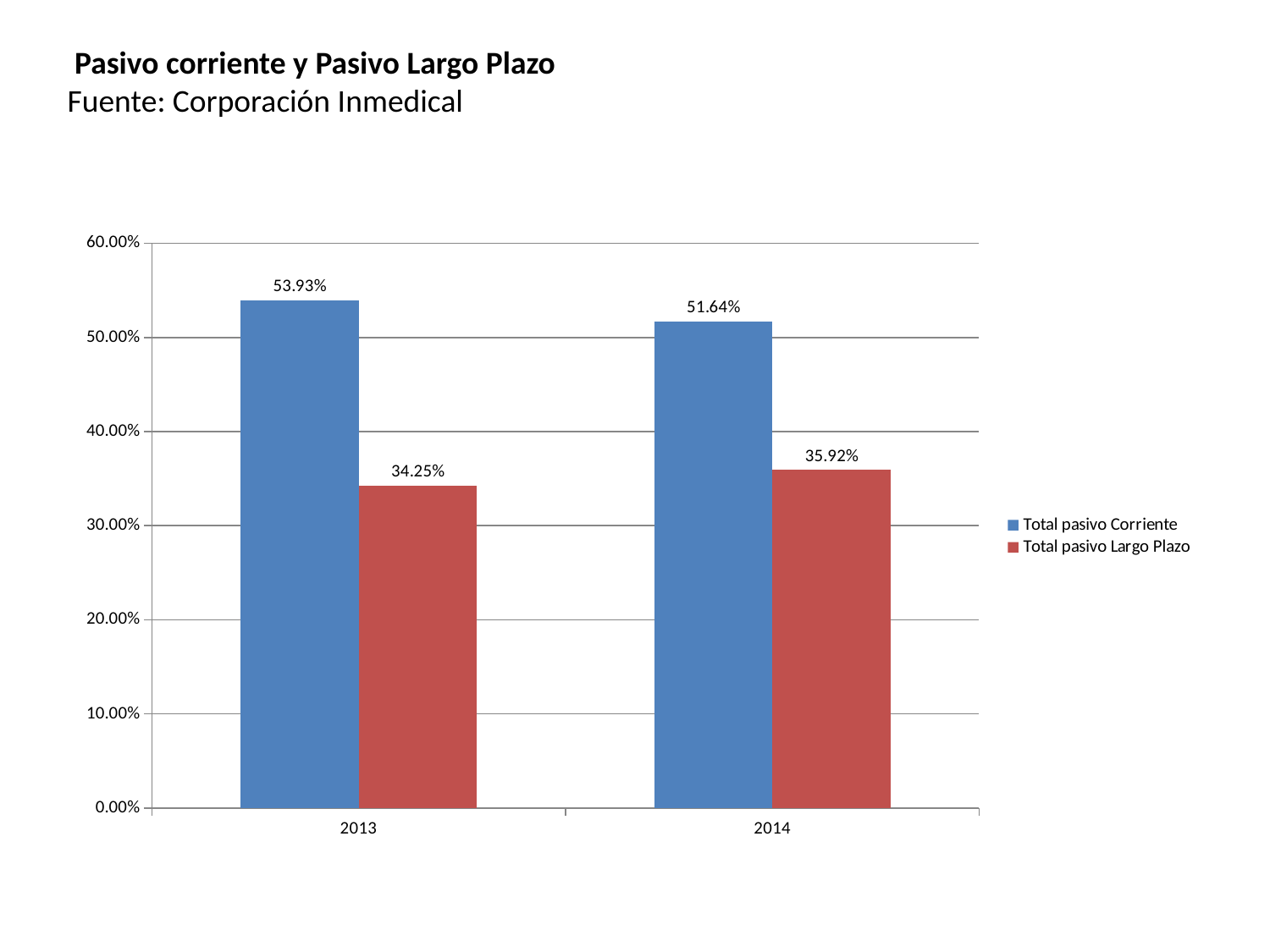
What is the value of Total pasivo Largo Plazo for 2014? 35.92% What is the value of Total pasivo Largo Plazo for 2013? 34.25% Which is larger in 2014, Total pasivo Corriente or Total pasivo Largo Plazo? Total pasivo Corriente What is the value of Total pasivo Corriente for 2013? 53.93% What kind of chart is shown on the slide? Bar chart How many years are shown on the x axis? 2 How many series does the legend list? 2 What is the difference between Total pasivo Corriente and Total pasivo Largo Plazo in 2013? 19.68% What is the value of Total pasivo Corriente for 2014? 51.64% In which year is Total pasivo Corriente highest? 2013 In which year is Total pasivo Largo Plazo lowest? 2013 Does Total pasivo Corriente rise or fall from 2013 to 2014? Fall